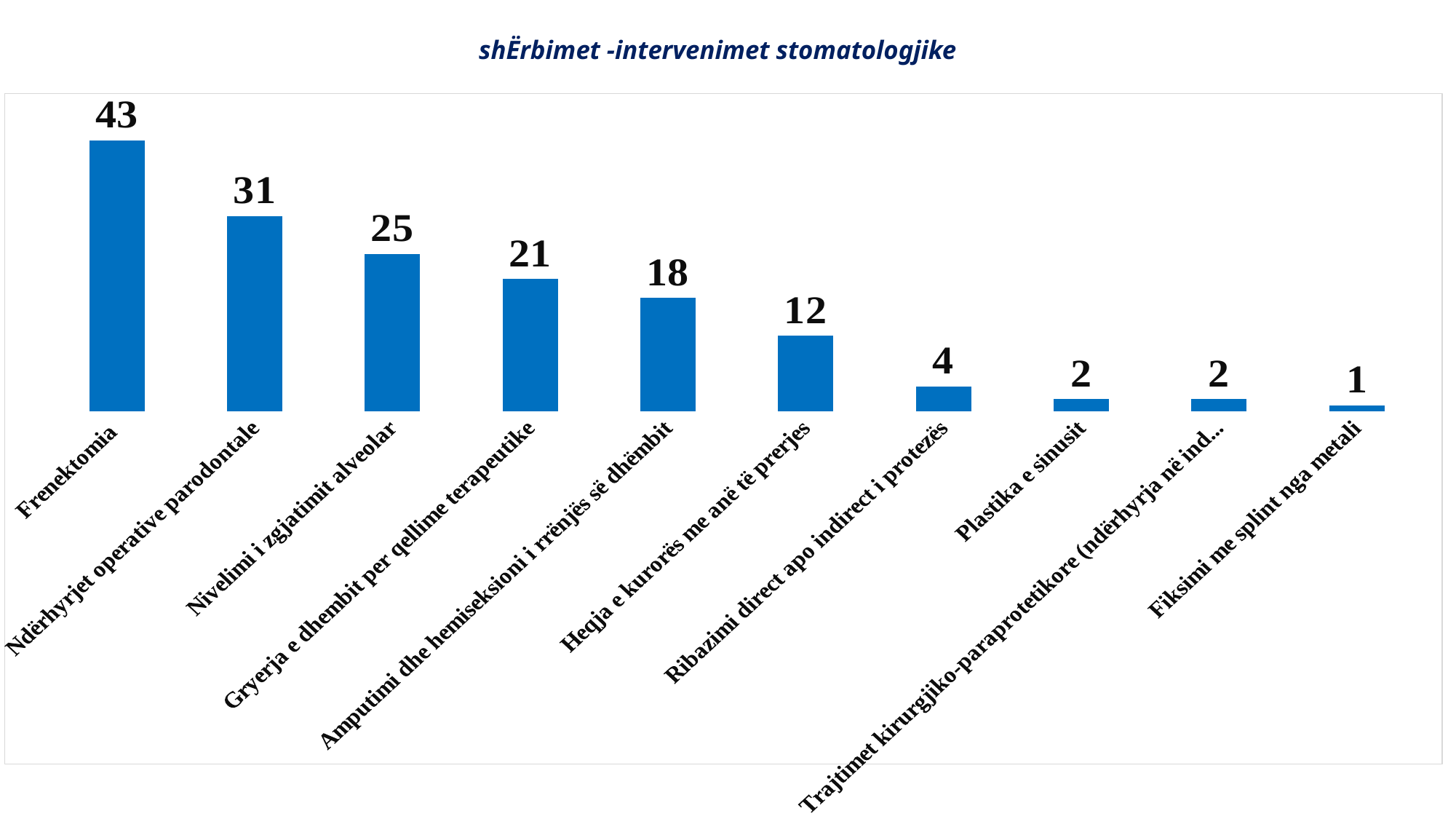
What is the difference between the values for Frenektomia and Ndërhyrjet operative parodontale? 12 Which is larger, the value for Amputimi dhe hemiseksioni i rrënjës së dhëmbit or the value for Heqja e kurorës me anë të prerjes? Amputimi dhe hemiseksioni i rrënjës së dhëmbit Which category has the highest value? Frenektomia How many categories are shown in the chart? 10 What is the value for Frenektomia? 43 Do the values rise or fall from left to right along the x axis? Fall What is the value for Heqja e kurorës me anë të prerjes? 12 What is the value for Nivelimi i zgjatinit alveolar? 25 What is the value for Plastika e sinusit? 2 Which category has the lowest value? Fiksimi me splint nga metali What kind of chart is shown on the slide? Bar chart What is the difference between the values for Gryerja e dhembit per qellime terapeutike and Ribazimi direct apo indirect i protezës? 17